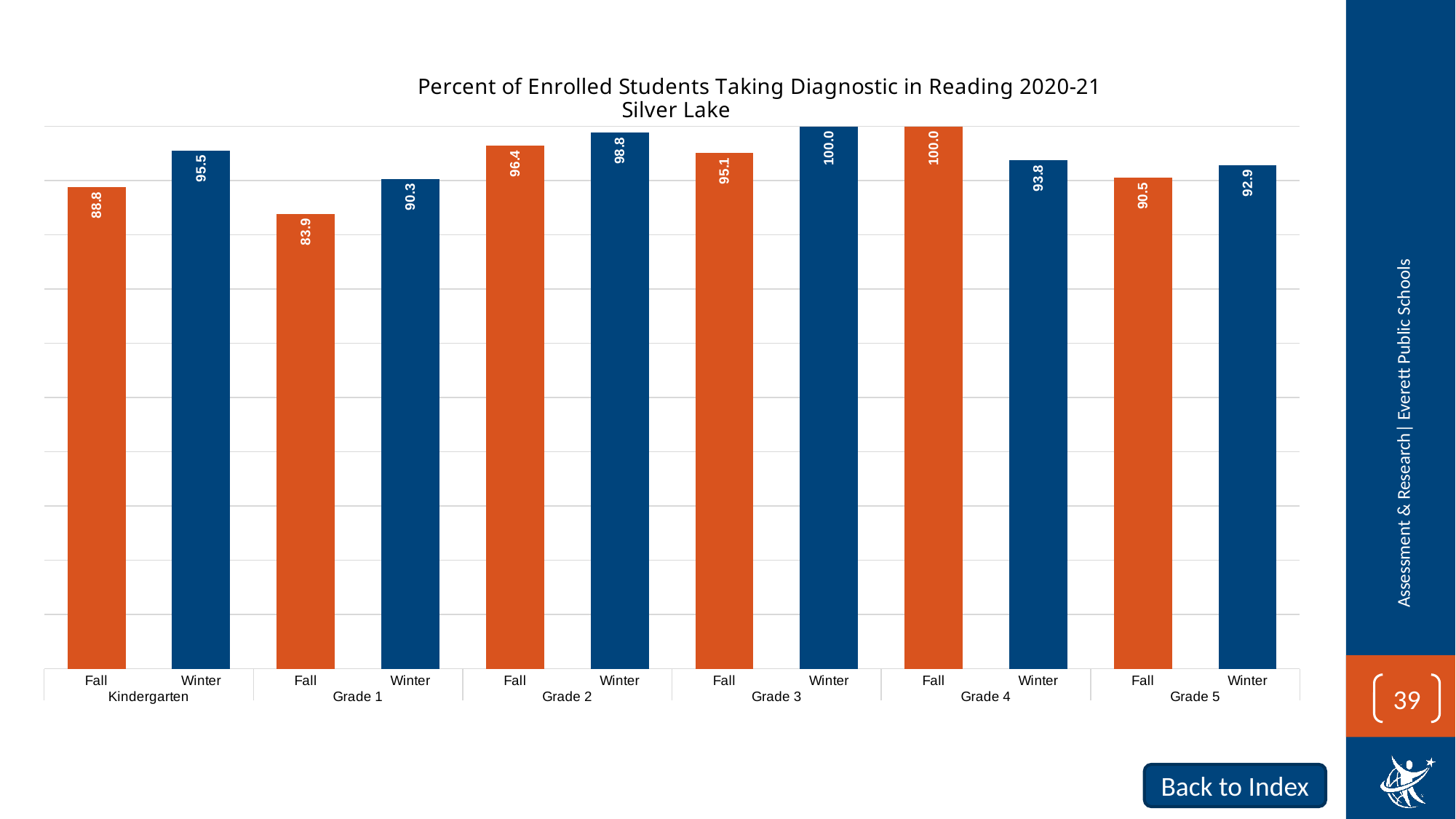
Which is larger, the Fall value for Grade 2 or the Fall value for Grade 3? Fall value for Grade 2 Which is larger, the Winter value for Kindergarten or the Winter value for Grade 5? Winter value for Kindergarten What is the difference between the Fall and Winter values for Grade 4? 6.2 What is the value for Fall in Kindergarten? 88.8 What is the difference between the Winter and Fall values for Grade 1? 6.4 What kind of chart is shown on the slide? Bar chart What is the value for Winter in Grade 5? 92.9 What is the value for Fall in Grade 4? 100.0 Which bar has the lowest value on the chart? Grade 1 Fall What is the value for Winter in Grade 1? 90.3 How many grade levels are shown on the chart? 6 What is the title of the chart? Percent of Enrolled Students Taking Diagnostic in Reading 2020-21 Silver Lake